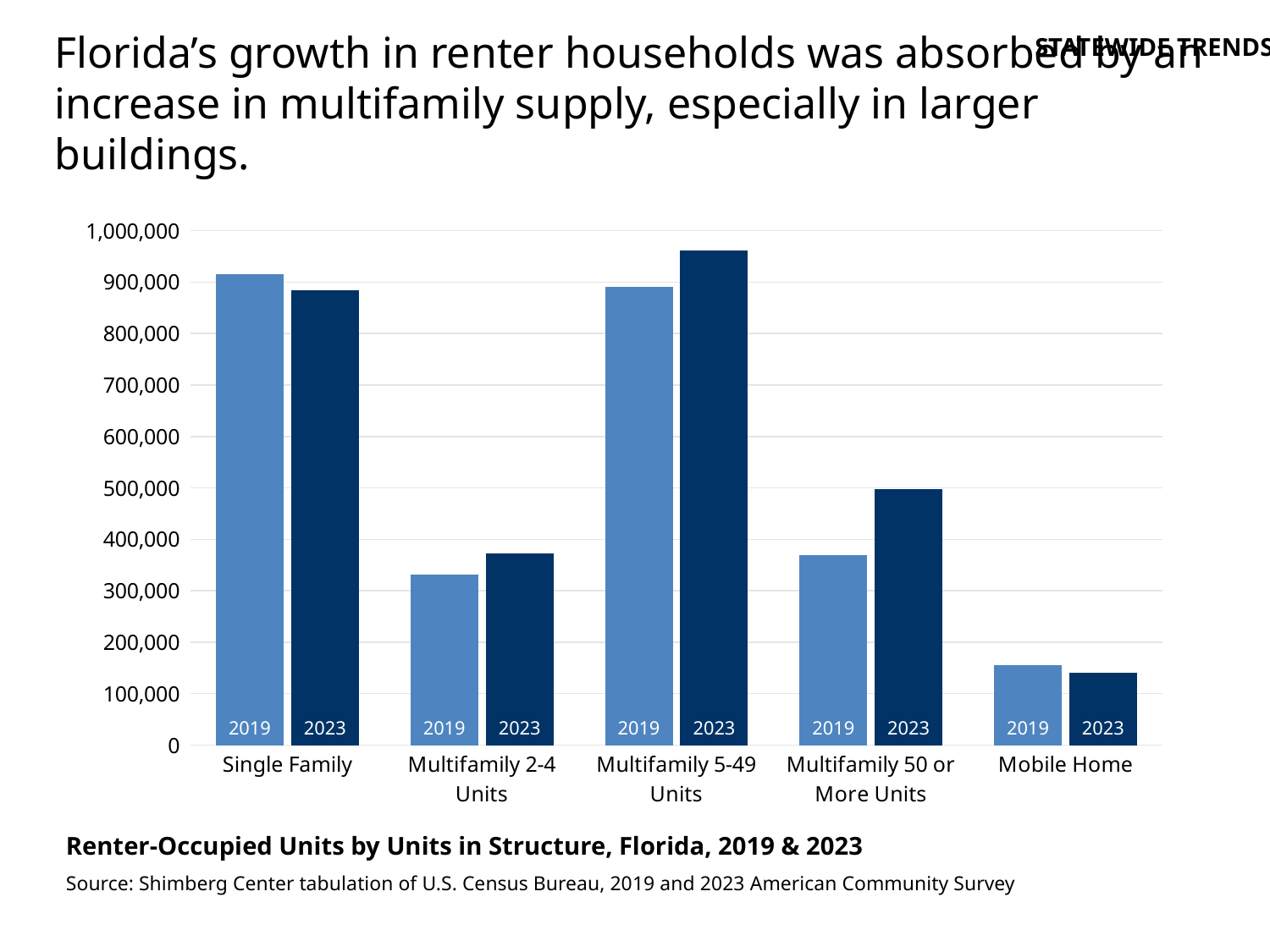
For Single Family, which year has the larger value, 2019 or 2023? 2019 Is the 2019 value for Multifamily 2-4 Units greater or less than 300,000? greater How many unit-in-structure categories are shown on the x axis? 5 Which category and year has the shortest bar? Mobile Home, 2023 Is the 2019 value for Mobile Home greater or less than 200,000? less Which is larger: the 2023 value for Multifamily 50 or More Units or the 2023 value for Multifamily 2-4 Units? Multifamily 50 or More Units Which category and year has the tallest bar? Multifamily 5-49 Units, 2023 Is the 2019 value for Single Family greater or less than 800,000? greater What is the title of the chart? Renter-Occupied Units by Units in Structure, Florida, 2019 & 2023 What kind of chart is shown on the slide? bar chart How many years (series) are plotted for each category? 2